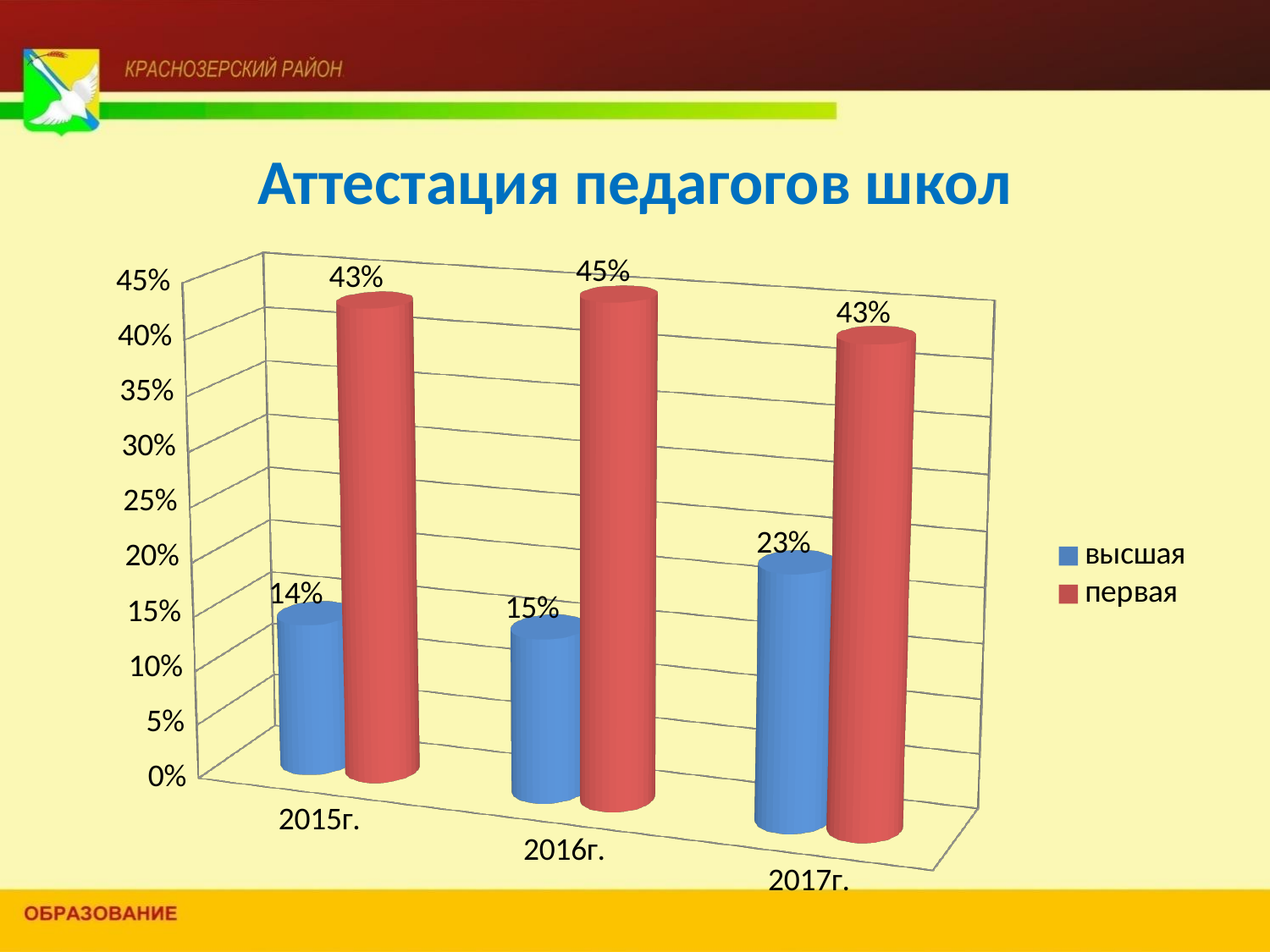
What is the difference between первая and высшая in 2016г.? 30% What is the title of the chart? Аттестация педагогов школ Which is larger in 2015г., высшая or первая? первая What is the value for высшая in 2015г.? 14% In which year is the value for высшая the highest? 2017г. What is the value for первая in 2017г.? 43% What is the value for высшая in 2017г.? 23% How many years are shown on the x axis? 3 What is the value for первая in 2016г.? 45% How many series does the legend list? 2 What kind of chart is shown on the slide? bar chart In which year is the value for высшая the lowest? 2015г.